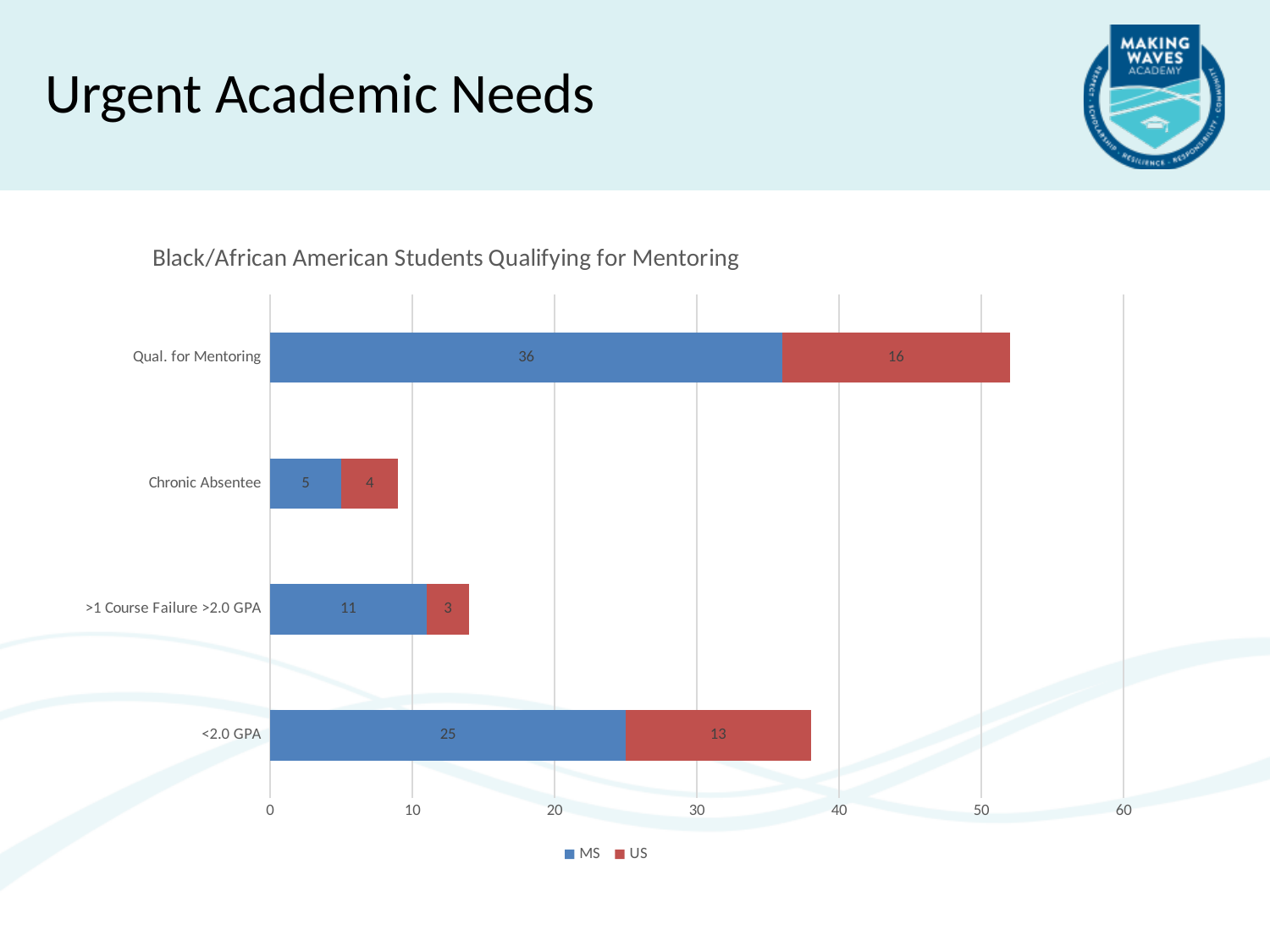
What is the MS value for >1 Course Failure >2.0 GPA? 11 How many series does the legend list? 2 What is the US value for Chronic Absentee? 4 What is the MS value for Qual. for Mentoring? 36 Which is larger, the MS value for <2.0 GPA or the MS value for Chronic Absentee? MS value for <2.0 GPA What is the total of the stacked bar for <2.0 GPA? 38 What is the US value for <2.0 GPA? 13 What type of chart is shown on the slide? Stacked bar chart How many categories are shown on the chart? 4 Which category has the highest MS value? Qual. for Mentoring What is the difference between the MS and US values for Qual. for Mentoring? 20 Which category has the lowest US value? >1 Course Failure >2.0 GPA